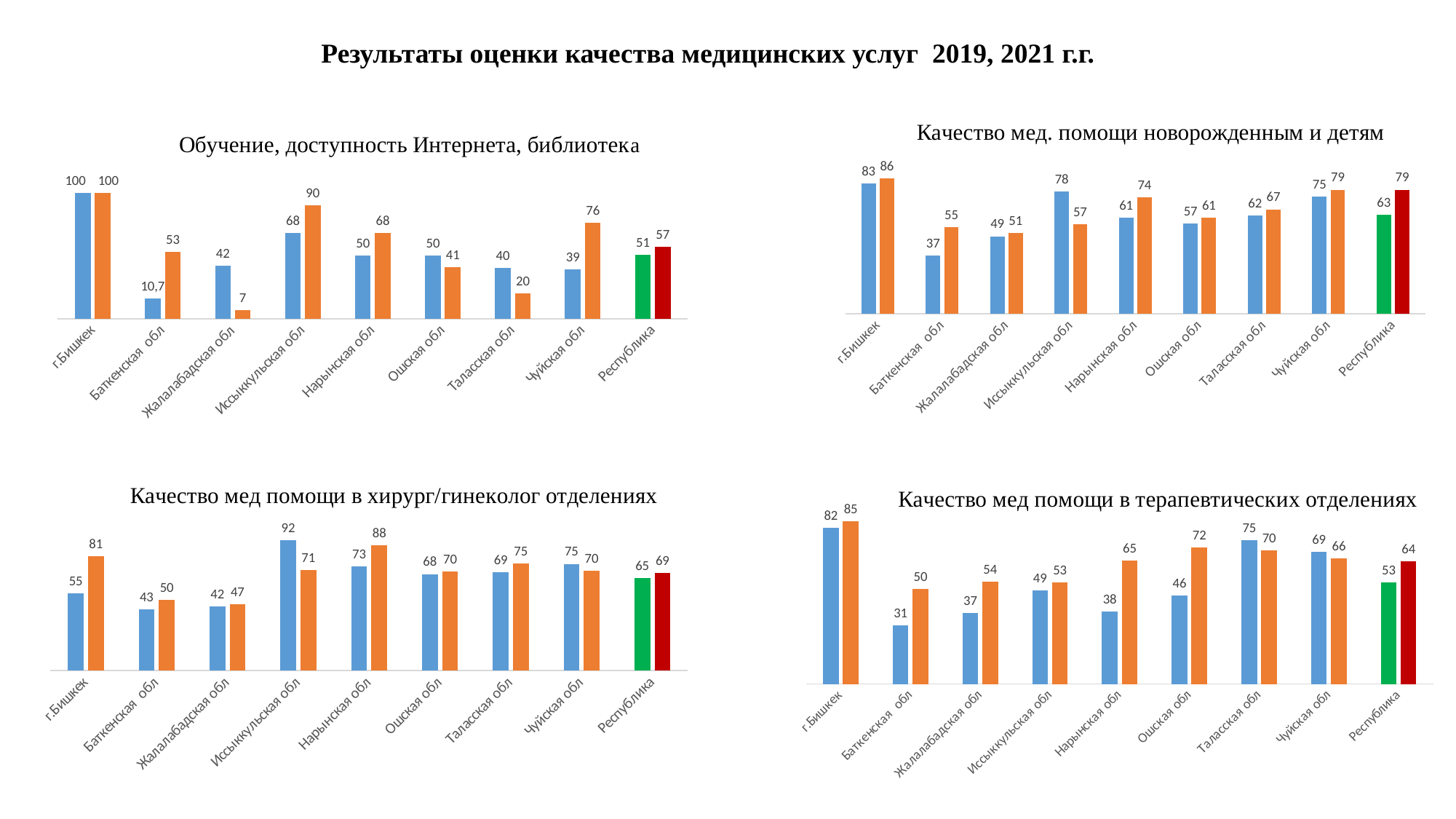
How many charts are shown on the slide? 4 In the chart 'Качество мед. помощи новорожденным и детям', what is the value of the red bar for Республика? 79 In the chart 'Качество мед помощи в терапевтических отделениях', what is the value of the blue bar for Баткенская обл? 31 In the chart 'Обучение, доступность Интернета, библиотека', which category has the lowest orange bar? Жалалабадская обл In the chart 'Качество мед помощи в терапевтических отделениях', what is the difference between the orange and blue bars for Нарынская обл? 27 In the chart 'Обучение, доступность Интернета, библиотека', what is the value of the blue bar for Баткенская обл? 10,7 In the chart 'Качество мед помощи в хирург/гинеколог отделениях', which is larger for Чуйская обл: the blue bar or the orange bar? the blue bar What type of chart is 'Качество мед помощи в терапевтических отделениях'? bar chart In the chart 'Качество мед. помощи новорожденным и детям', which category has the highest orange bar? г.Бишкек In the chart 'Качество мед помощи в хирург/гинеколог отделениях', what is the value of the blue bar for Иссыккульская обл? 92 In the chart 'Качество мед. помощи новорожденным и детям', what is the difference between the two bars for Баткенская обл? 18 In the chart 'Обучение, доступность Интернета, библиотека', what is the value of the orange bar for Баткенская обл? 53